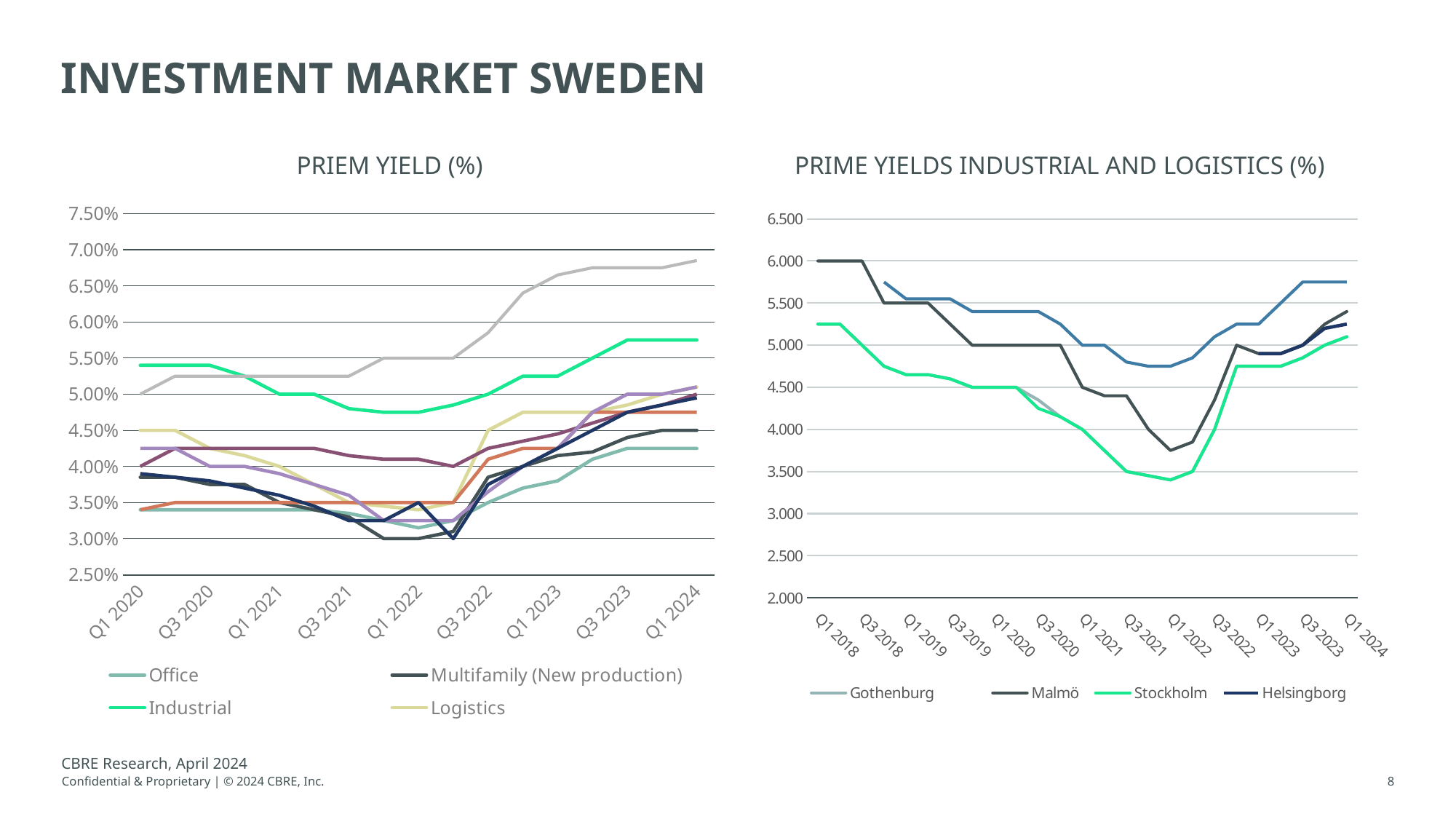
In the PRIME YIELDS INDUSTRIAL AND LOGISTICS (%) chart, is the Stockholm value at Q1 2022 greater or less than 3.500? less In the PRIEM YIELD (%) chart, is the Industrial value at Q1 2024 greater or less than 5.50%? greater In the PRIME YIELDS INDUSTRIAL AND LOGISTICS (%) chart, which city has the highest yield at Q1 2024? Malmö In the PRIEM YIELD (%) chart, does the Industrial line rise or fall from Q1 2022 to Q1 2024? Rise How many series does the legend of the PRIME YIELDS INDUSTRIAL AND LOGISTICS (%) chart list? 4 What is the title of the chart on the right side of the slide? PRIME YIELDS INDUSTRIAL AND LOGISTICS (%) In the PRIME YIELDS INDUSTRIAL AND LOGISTICS (%) chart, is the Helsingborg value at Q1 2024 greater or less than 5.500? less How many series does the legend of the PRIEM YIELD (%) chart list? 4 In the PRIEM YIELD (%) chart, which is higher at Q1 2024, Industrial or Office? Industrial In the PRIME YIELDS INDUSTRIAL AND LOGISTICS (%) chart, does the Stockholm line rise or fall from Q1 2018 to Q1 2022? Fall What type of chart is the PRIEM YIELD (%) chart on the left? Line chart